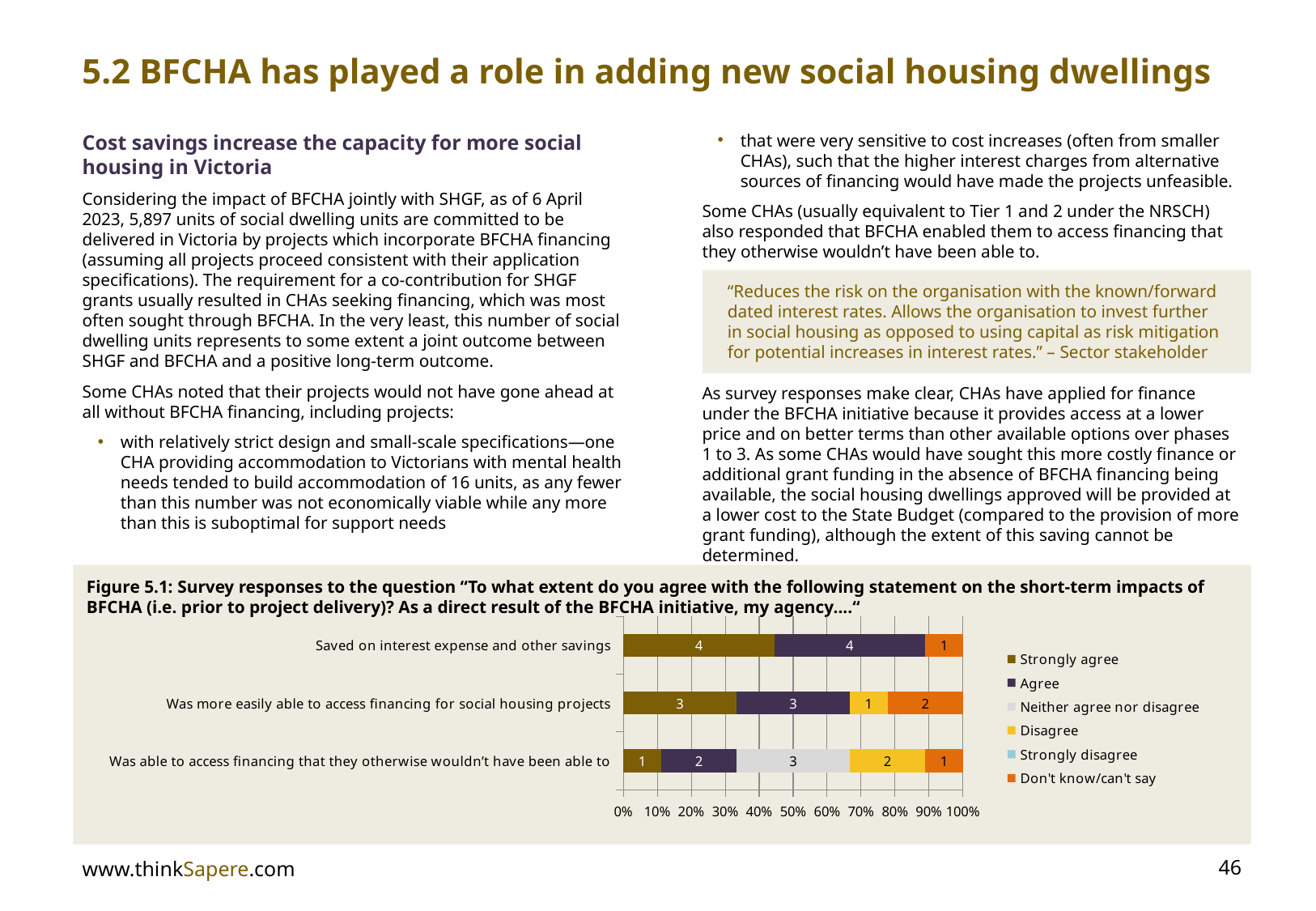
In Figure 5.1, which statement has the lowest number of 'Strongly agree' responses? Was able to access financing that they otherwise wouldn't have been able to How many statements (categories) are plotted in Figure 5.1? 3 In Figure 5.1, which is larger: the 'Agree' count for 'Saved on interest expense and other savings' or the 'Agree' count for 'Was able to access financing that they otherwise wouldn't have been able to'? Saved on interest expense and other savings In Figure 5.1, what is the difference between the 'Strongly agree' count for 'Saved on interest expense and other savings' and the 'Strongly agree' count for 'Was more easily able to access financing for social housing projects'? 1 In Figure 5.1, how many respondents answered 'Neither agree nor disagree' for 'Was able to access financing that they otherwise wouldn't have been able to'? 3 In Figure 5.1, how many respondents strongly agreed that their agency 'Saved on interest expense and other savings'? 4 What kind of chart is shown in Figure 5.1? Stacked bar chart In Figure 5.1, how many respondents answered 'Don't know/can't say' for 'Was more easily able to access financing for social housing projects'? 2 In Figure 5.1, what is the total number of responses for 'Saved on interest expense and other savings'? 9 In Figure 5.1, how many respondents disagreed with 'Was able to access financing that they otherwise wouldn't have been able to'? 2 How many series does the legend of Figure 5.1 list? 6 In Figure 5.1, which statement has the highest number of 'Strongly agree' responses? Saved on interest expense and other savings